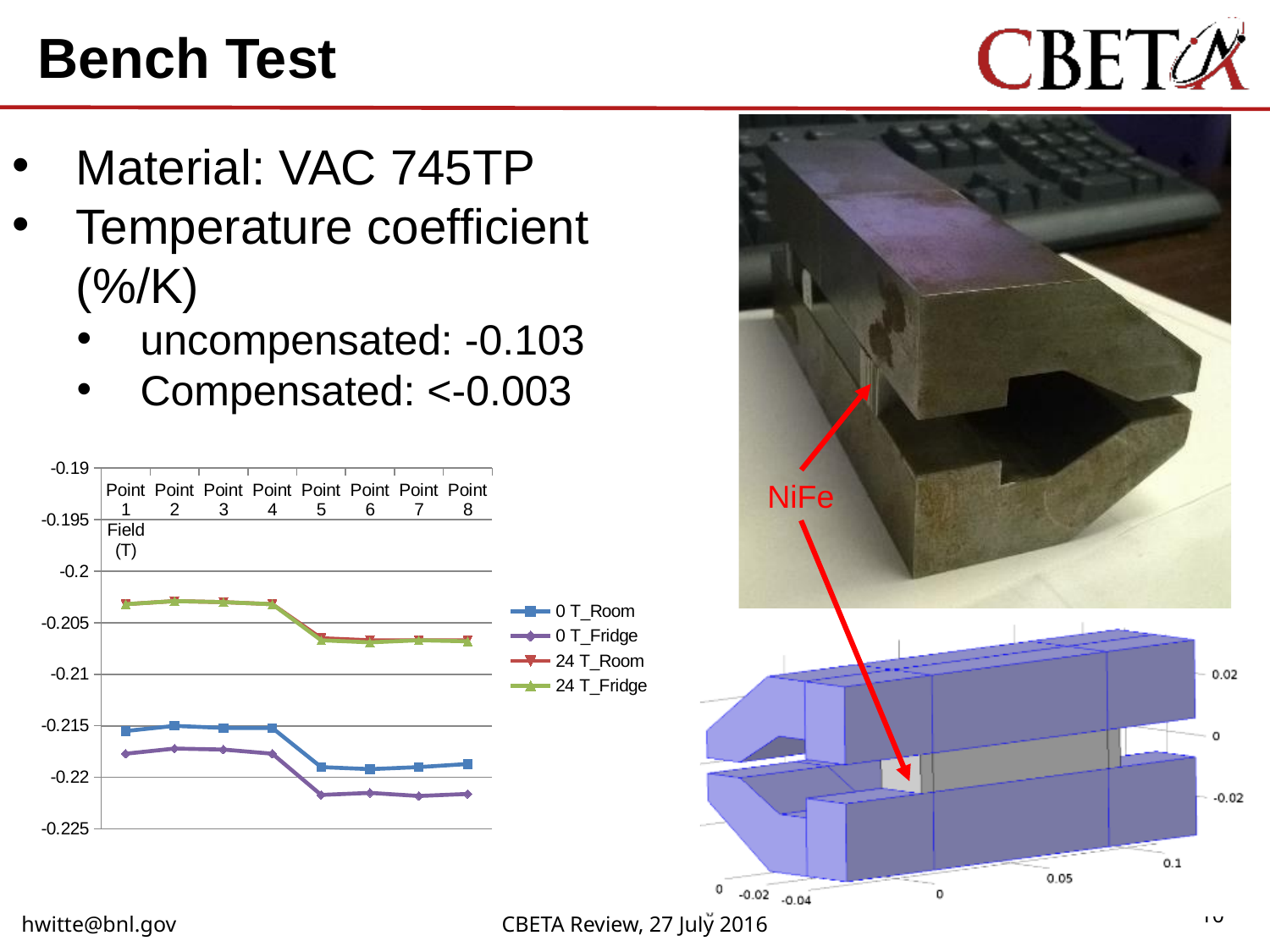
At Point 1, which is larger: the value for 0 T_Room or the value for 0 T_Fridge? 0 T_Room Do the values for 0 T_Room rise or fall from Point 1 to Point 8? fall Is the value for 0 T_Room at Point 1 greater or less than -0.21? less How many points are plotted along the x axis of the chart? 8 At Point 3, which is larger: the value for 24 T_Room or the value for 0 T_Room? 24 T_Room Is the value for 24 T_Room at Point 1 greater or less than -0.205? greater How many series does the chart legend list? 4 Is the value for 0 T_Fridge at Point 5 greater or less than -0.22? less Which series has the lowest values across the chart? 0 T_Fridge What kind of chart is shown on the slide? line chart